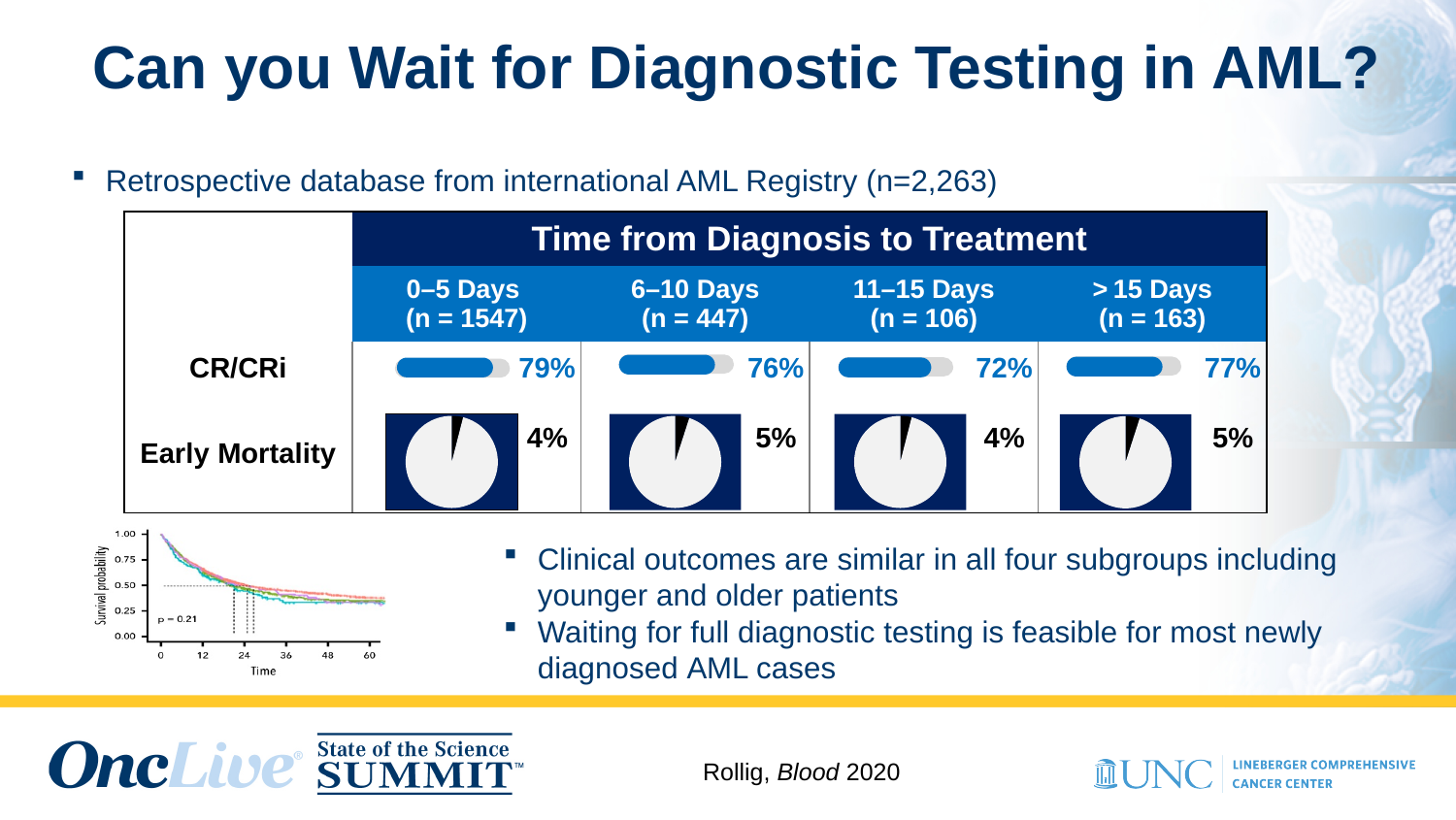
How many time-from-diagnosis-to-treatment groups are shown in the table? 4 In the Time from Diagnosis to Treatment table, what is the Early Mortality rate for the > 15 Days group? 5% In the Time from Diagnosis to Treatment table, what is the Early Mortality rate for the 6–10 Days group? 5% In the Time from Diagnosis to Treatment table, which time group has the lowest CR/CRi rate? 11–15 Days In the Time from Diagnosis to Treatment table, which time group has the highest CR/CRi rate? 0–5 Days In the Time from Diagnosis to Treatment table, which group has a higher CR/CRi rate, 6–10 Days or > 15 Days? > 15 Days In the Time from Diagnosis to Treatment table, what is the CR/CRi rate for the 0–5 Days group? 79% In the Time from Diagnosis to Treatment table, how many patients are in the 6–10 Days group? 447 In the survival curve chart at the bottom left, what p-value is printed? p = 0.21 What kind of chart is used to show Early Mortality in the Time from Diagnosis to Treatment table? Pie chart In the Time from Diagnosis to Treatment table, what is the difference in CR/CRi rate between the 0–5 Days group and the 11–15 Days group? 7 percentage points In the Time from Diagnosis to Treatment table, what is the CR/CRi rate for the 11–15 Days group? 72%